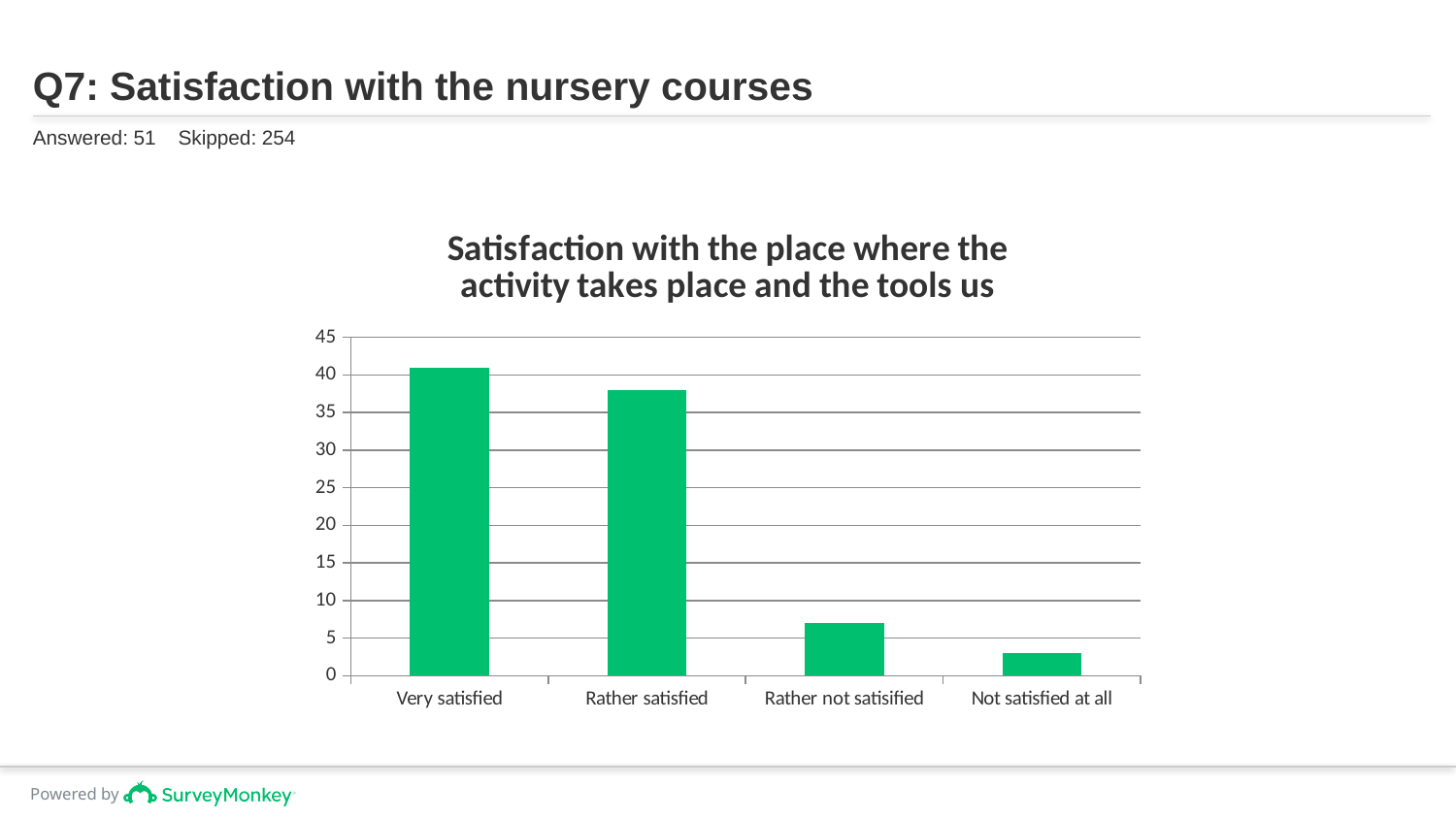
Which category has the highest value in the chart? Very satisfied Which category has the lowest value in the chart? Not satisfied at all What kind of chart is shown on the slide? Bar chart What is the title of the chart? Satisfaction with the place where the activity takes place and the tools us Is the value for Not satisfied at all greater or less than 5? less Is the value for Rather satisfied greater or less than 35? greater Is the value for Rather not satisified greater or less than 10? less Do the values rise or fall moving from left to right along the x axis? Fall What colour are the bars in the chart? Green How many categories are shown on the x axis of the chart? 4 Which is larger, the value for Rather not satisified or the value for Not satisfied at all? Rather not satisified